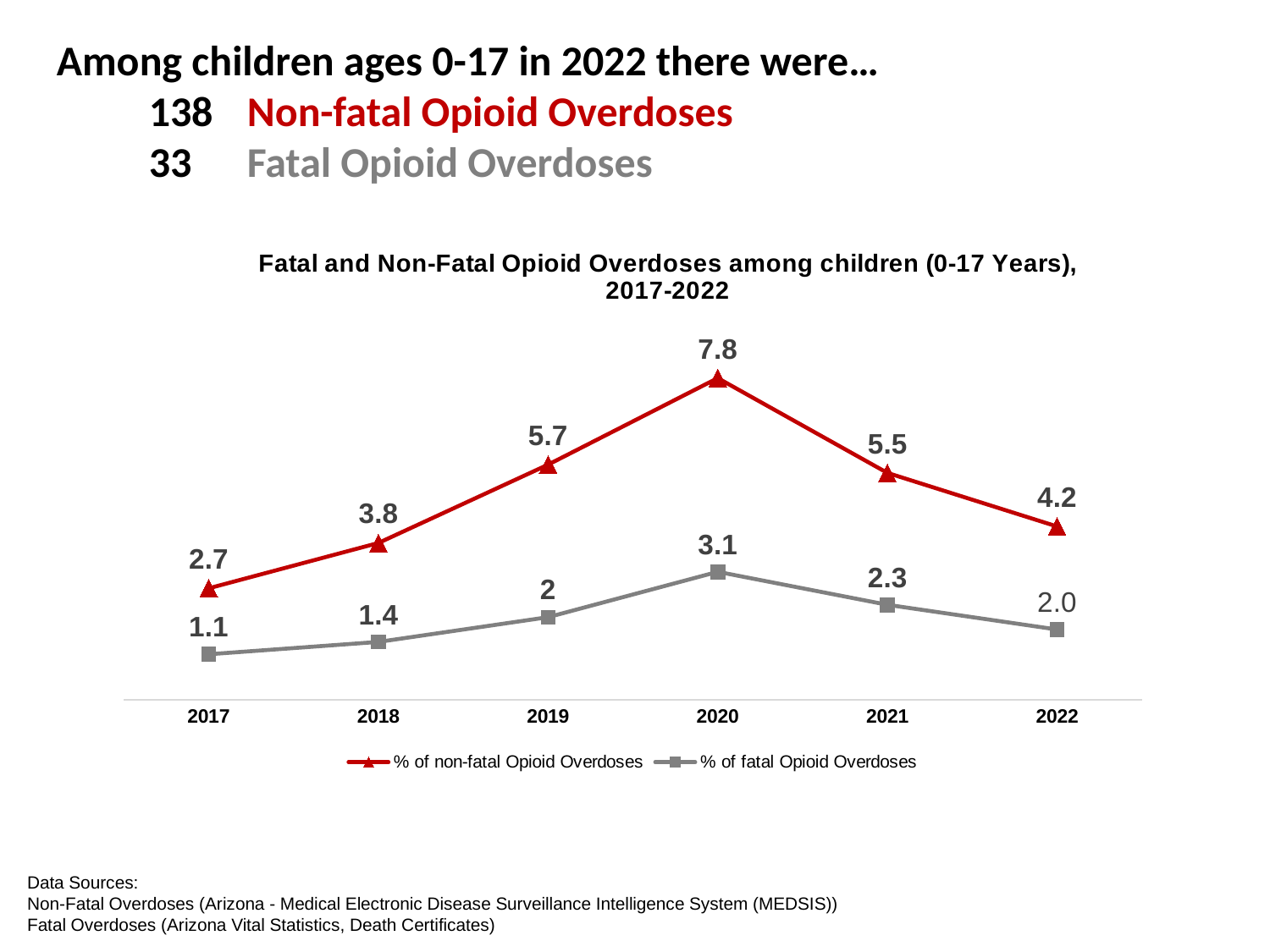
Does the % of fatal Opioid Overdoses rise or fall from 2017 to 2020? Rise In which year is the % of fatal Opioid Overdoses lowest? 2017 What is the % of fatal Opioid Overdoses in 2022? 2.0 Which is larger: the % of non-fatal Opioid Overdoses in 2018 or in 2021? 2021 How many years are shown on the x axis? 6 What kind of chart is shown on the slide? Line chart How many series does the legend list? 2 What is the % of non-fatal Opioid Overdoses in 2020? 7.8 What is the % of fatal Opioid Overdoses in 2019? 2 What is the difference between the % of non-fatal Opioid Overdoses in 2020 and in 2019? 2.1 What is the difference between the % of non-fatal and % of fatal Opioid Overdoses in 2022? 2.2 In which year is the % of non-fatal Opioid Overdoses highest? 2020